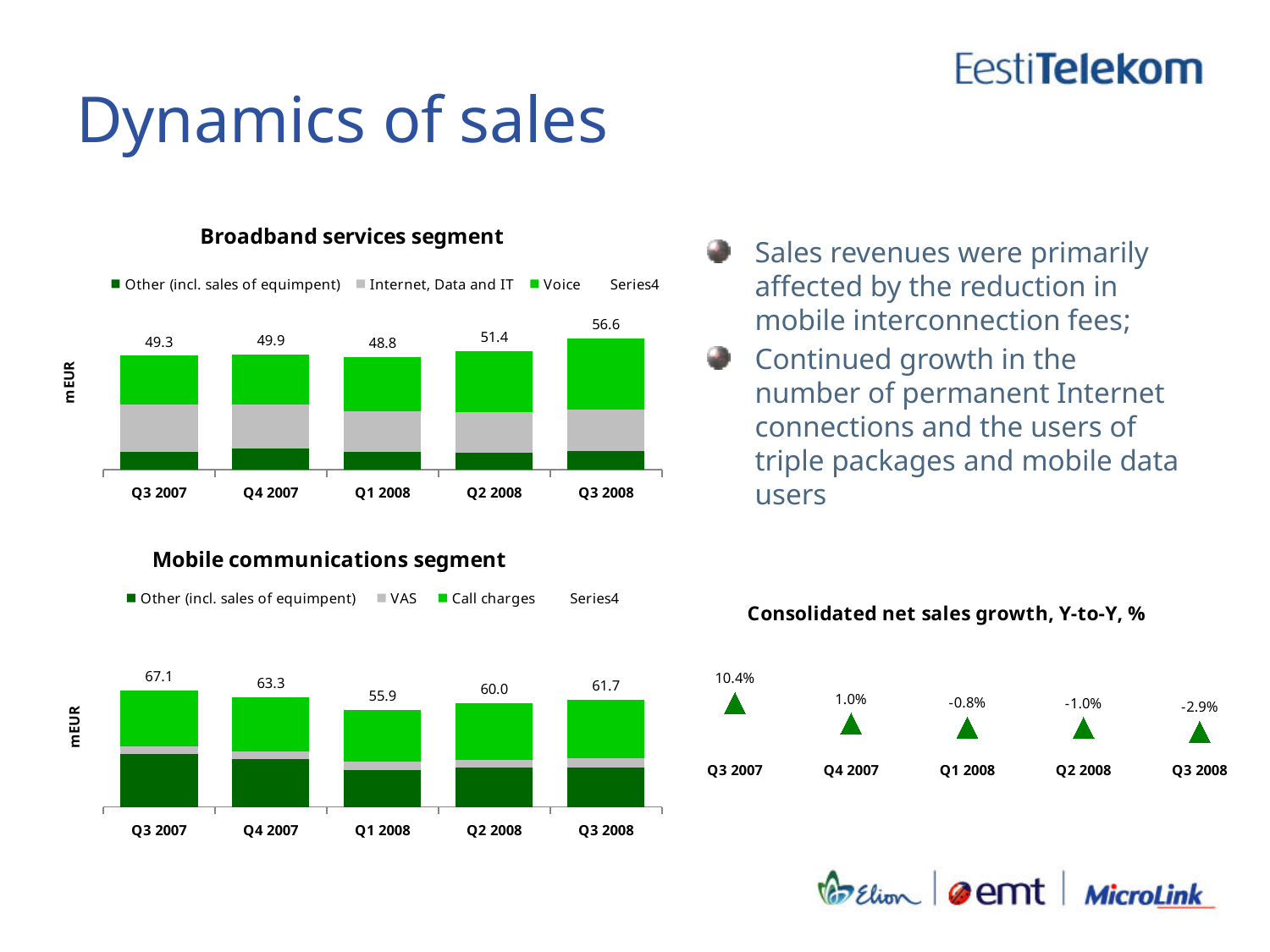
In the Mobile communications segment chart, what is the difference between the totals for Q3 2007 and Q1 2008? 11.2 What kind of chart is the Mobile communications segment chart? stacked bar chart In the Broadband services segment chart, what is the difference between the totals for Q3 2008 and Q3 2007? 7.3 In the Mobile communications segment chart, is the total for Q2 2008 larger or smaller than the total for Q3 2008? smaller In the Broadband services segment chart, what is the total value labelled for Q3 2008? 56.6 In the Consolidated net sales growth chart, what is the value for Q3 2007? 10.4% In the Mobile communications segment chart, what is the total value labelled for Q1 2008? 55.9 How many quarters are shown on the x axis of the Broadband services segment chart? 5 In the Broadband services segment chart, which quarter has the lowest total? Q1 2008 In the Mobile communications segment chart, which quarter has the highest total? Q3 2007 In the Consolidated net sales growth chart, which quarter has the lowest value? Q3 2008 In the Consolidated net sales growth chart, do the values rise or fall from Q3 2007 to Q3 2008? fall